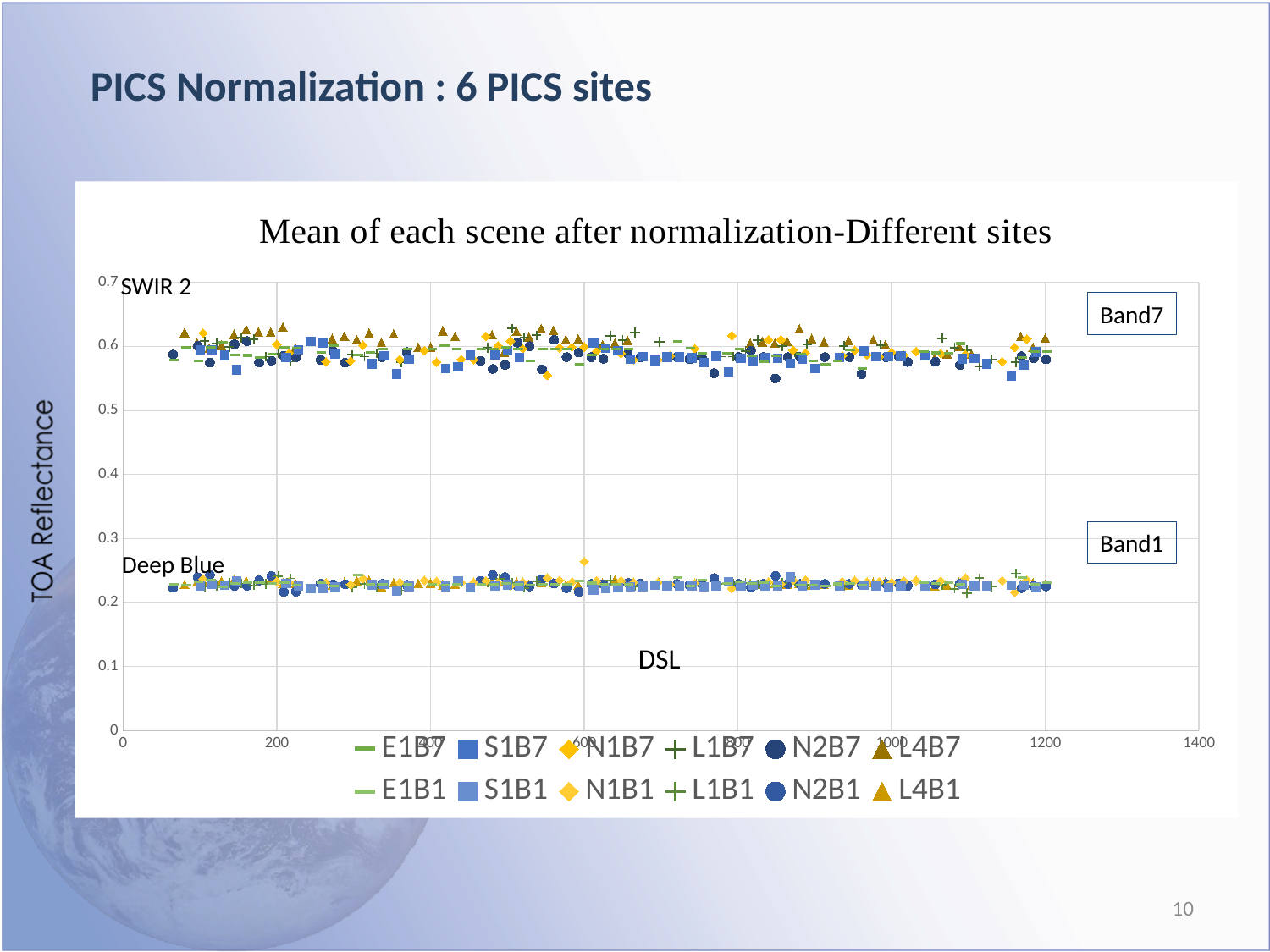
Are the Band7 points plotted at values greater or less than 0.5? greater How many series does the chart legend list? 12 What is the label on the vertical axis of the chart? TOA Reflectance What is the maximum value shown on the vertical axis of the chart? 0.7 What kind of chart is shown on the slide? Scatter chart Are the Band1 (Deep Blue) points plotted at values greater or less than 0.3? less Which group of points is plotted higher on the chart, Band7 or Band1? Band7 Are the Band7 (SWIR 2) points plotted at values greater or less than 0.4? greater What is the title of the chart? Mean of each scene after normalization-Different sites Do the Band7 values rise, fall, or stay roughly flat as DSL increases along the x axis? Roughly flat Do the Band1 values rise, fall, or stay roughly flat as DSL increases along the x axis? Roughly flat